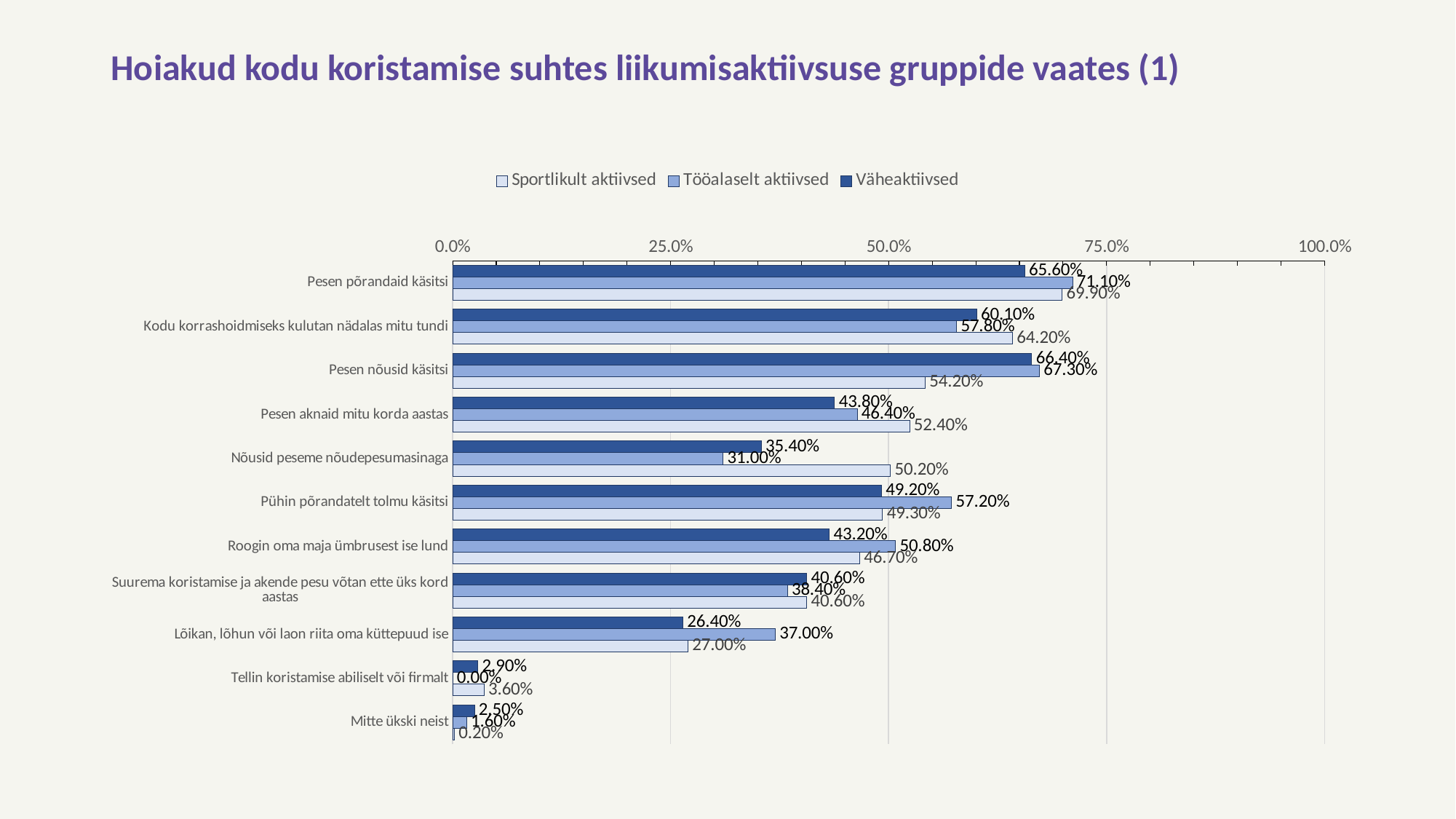
How many categories are shown on the chart? 11 Is the Sportlikult aktiivsed value for "Pesen aknaid mitu korda aastas" greater or less than 50.0%? greater What kind of chart is shown on the slide? Bar chart What is the value for Tööalaselt aktiivsed for "Lõikan, lõhun või laon riita oma küttepuud ise"? 37.00% For "Pesen nõusid käsitsi", which is larger: the Väheaktiivsed value or the Sportlikult aktiivsed value? Väheaktiivsed Which category has the lowest value for Sportlikult aktiivsed? Mitte ükski neist How many series does the legend list? 3 What is the value for Sportlikult aktiivsed for "Pesen põrandaid käsitsi"? 69.90% What is the value for Väheaktiivsed for "Nõusid peseme nõudepesumasinaga"? 35.40% What is the title of the slide? Hoiakud kodu koristamise suhtes liikumisaktiivsuse gruppide vaates (1) Which category has the highest value for Tööalaselt aktiivsed? Pesen põrandaid käsitsi What is the difference between the Sportlikult aktiivsed and Tööalaselt aktiivsed values for "Nõusid peseme nõudepesumasinaga"? 19.20%